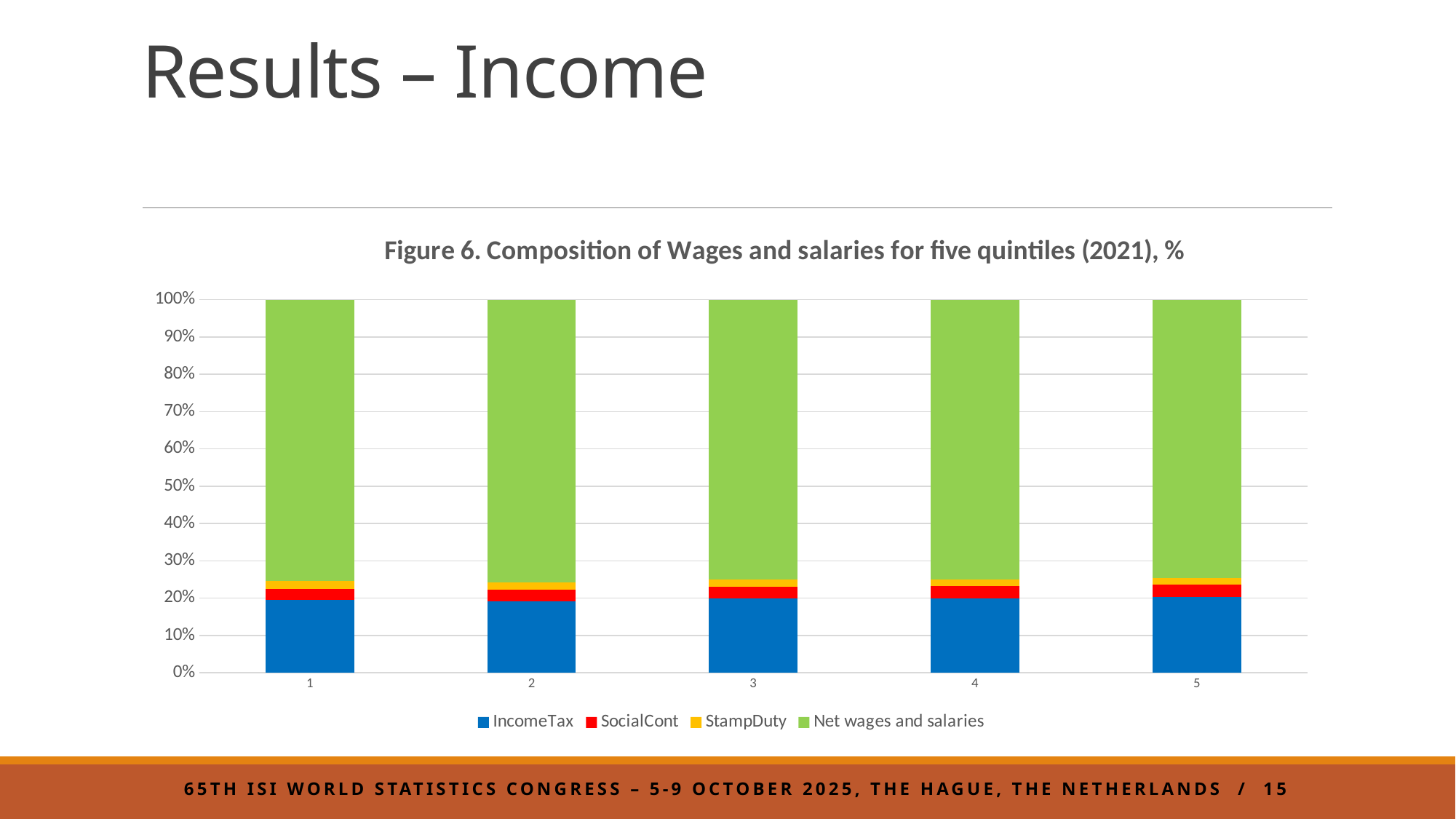
Is the IncomeTax share for quintile 5 greater or less than 10%? greater Is the SocialCont share for quintile 4 greater or less than 10%? less How many series does the legend list? 4 Which series makes up the smallest share of the bar for quintile 5? StampDuty What is the total height of the stacked bar for quintile 3? 100% Which series is shown in green in the legend? Net wages and salaries Which series makes up the largest share of the bar for quintile 1? Net wages and salaries What is the title of the chart? Figure 6. Composition of Wages and salaries for five quintiles (2021), % For quintile 2, which is larger: the IncomeTax segment or the SocialCont segment? IncomeTax How many quintile categories are shown on the x axis? 5 Is the Net wages and salaries share for quintile 1 greater or less than 70%? greater What kind of chart is shown on the slide? Stacked bar chart